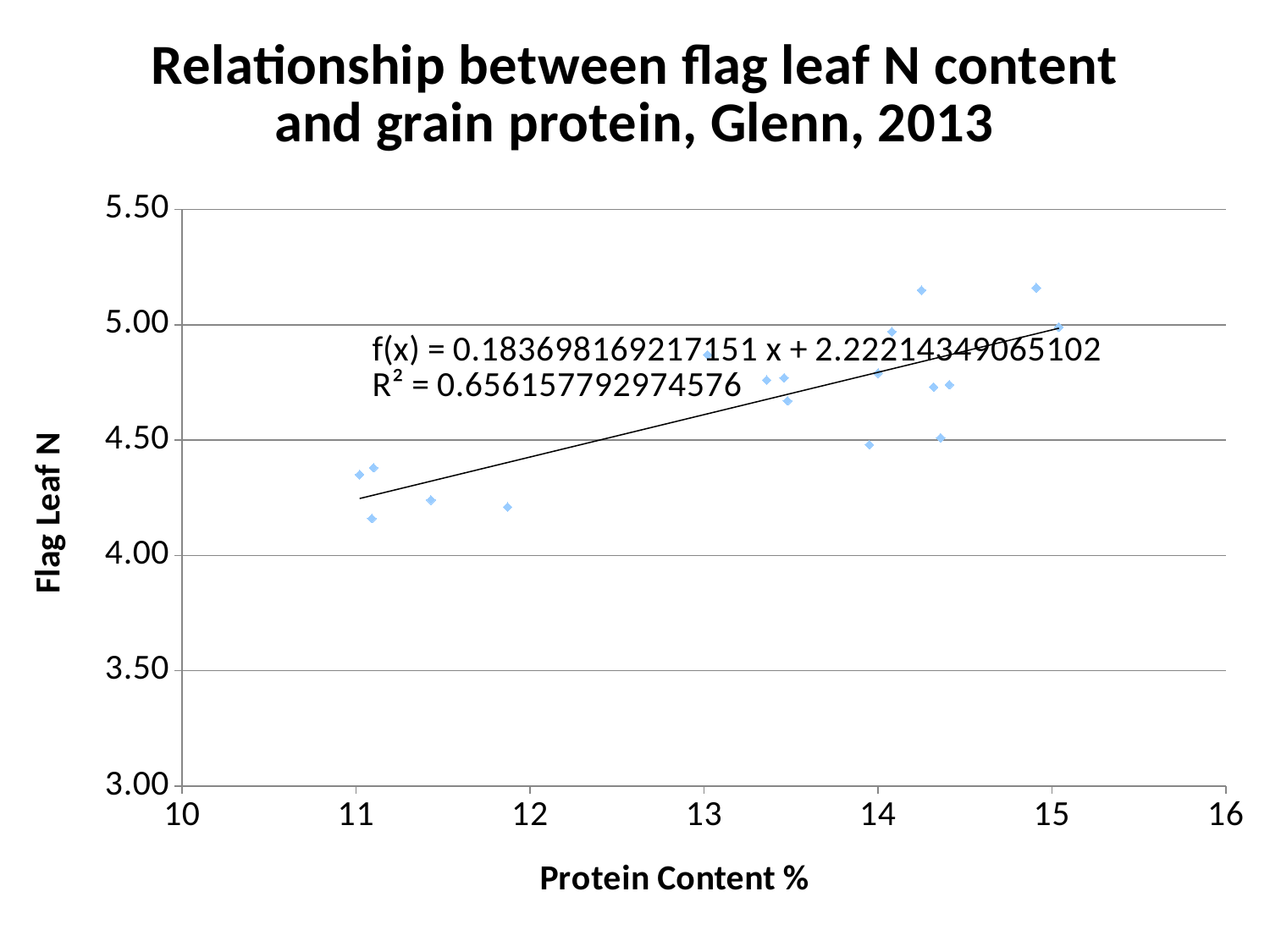
Is the Flag Leaf N value for the point at roughly 14.9% protein greater or less than 5.00? greater Does Flag Leaf N generally rise or fall as Protein Content % increases? rise What is the title of the chart? Relationship between flag leaf N content and grain protein, Glenn, 2013 What is the intercept of the fitted line f(x) shown on the chart? 2.22214349065102 What is the R² value shown for the trendline? 0.656157792974576 What kind of chart is shown on the slide? scatter plot What is the maximum value shown on the Flag Leaf N axis? 5.50 What is the label of the x axis? Protein Content % What is the slope of the fitted line f(x) shown on the chart? 0.183698169217151 Is the Flag Leaf N value for the point at roughly 13.0% protein greater or less than 4.50? greater Are the points near 11% protein higher or lower in Flag Leaf N than the points near 14% protein? lower Is the Flag Leaf N value for the point at roughly 11.9% protein greater or less than 4.50? less